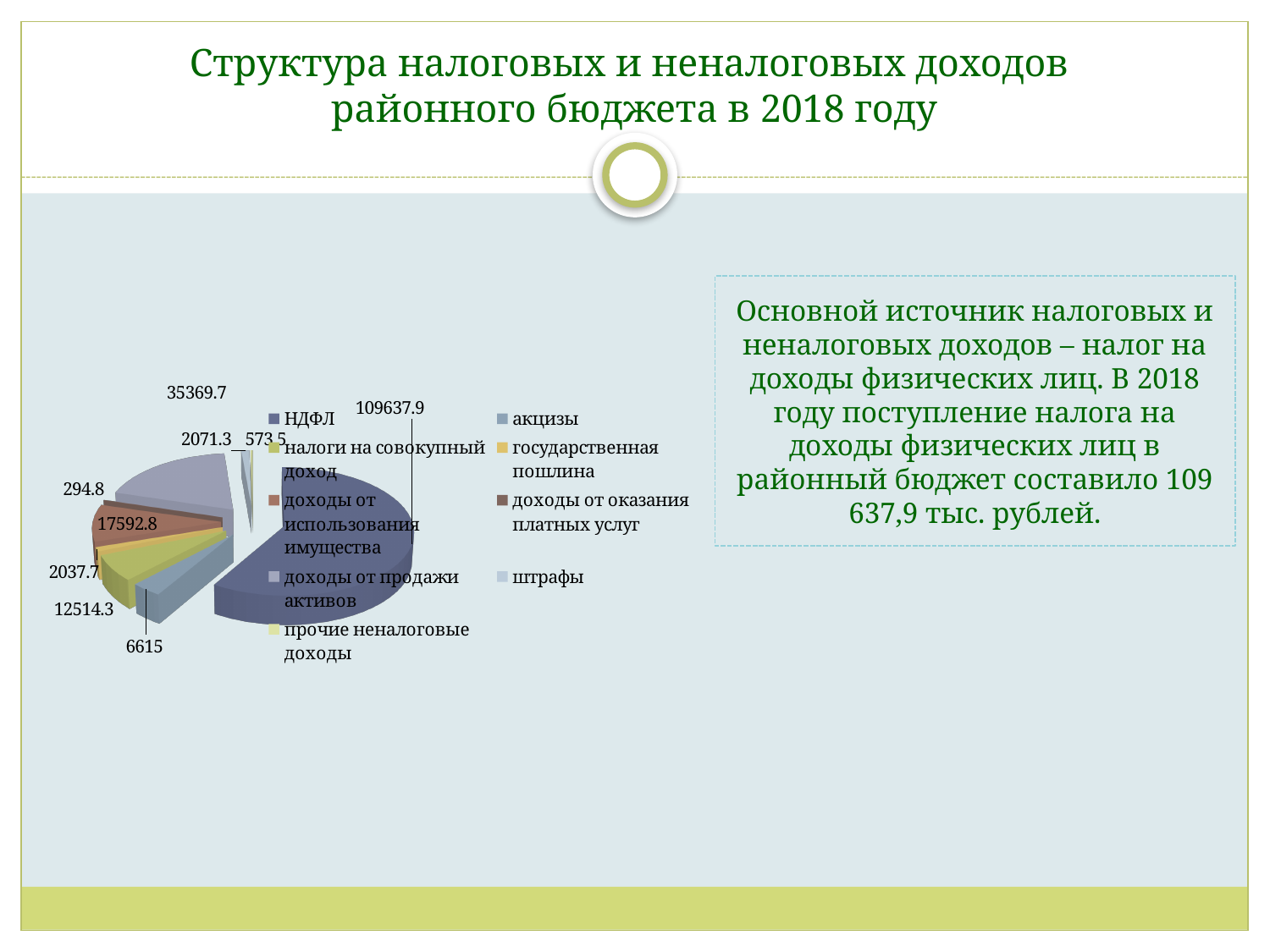
Which category has the largest slice of the pie chart? НДФЛ What kind of chart is shown on the slide? pie chart What is the smallest data label shown on the pie chart? 294.8 What is the title of the slide containing the pie chart? Структура налоговых и неналоговых доходов районного бюджета в 2018 году How many slices (data labels) does the pie chart have? 9 What is the largest data label shown on the pie chart? 109637.9 How many entries does the legend of the pie chart list? 9 What value is shown for НДФЛ on the pie chart? 109637.9 What is the difference between the largest data label (109637.9) and the second largest (35369.7) on the pie chart? 74268.2 Is the value for НДФЛ greater or less than 100000? greater Which legend entry is listed first in the pie chart's legend? НДФЛ